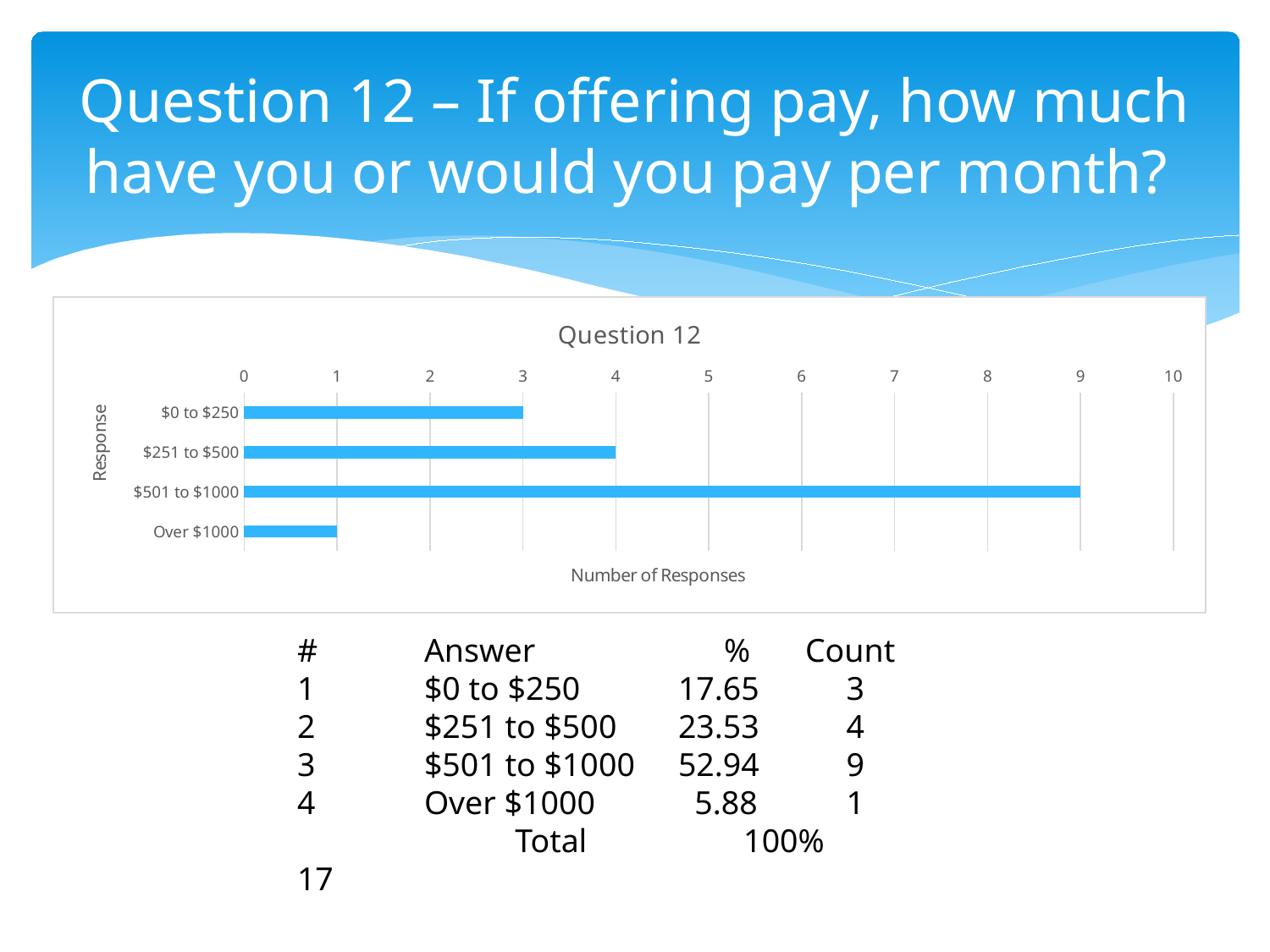
What is the difference in number of responses between "$501 to $1000" and "$251 to $500"? 5 Which response category has the lowest number of responses? Over $1000 Which response category has the highest number of responses? $501 to $1000 Is the number of responses for "$501 to $1000" greater or less than 5? greater What is the number of responses for "$501 to $1000"? 9 How many response categories are plotted in the chart? 4 What is the label of the horizontal axis of the chart? Number of Responses What is the number of responses for "$0 to $250"? 3 What is the title of the chart? Question 12 What kind of chart is shown on the slide? bar chart What is the number of responses for "Over $1000"? 1 Which has more responses, "$251 to $500" or "$0 to $250"? $251 to $500